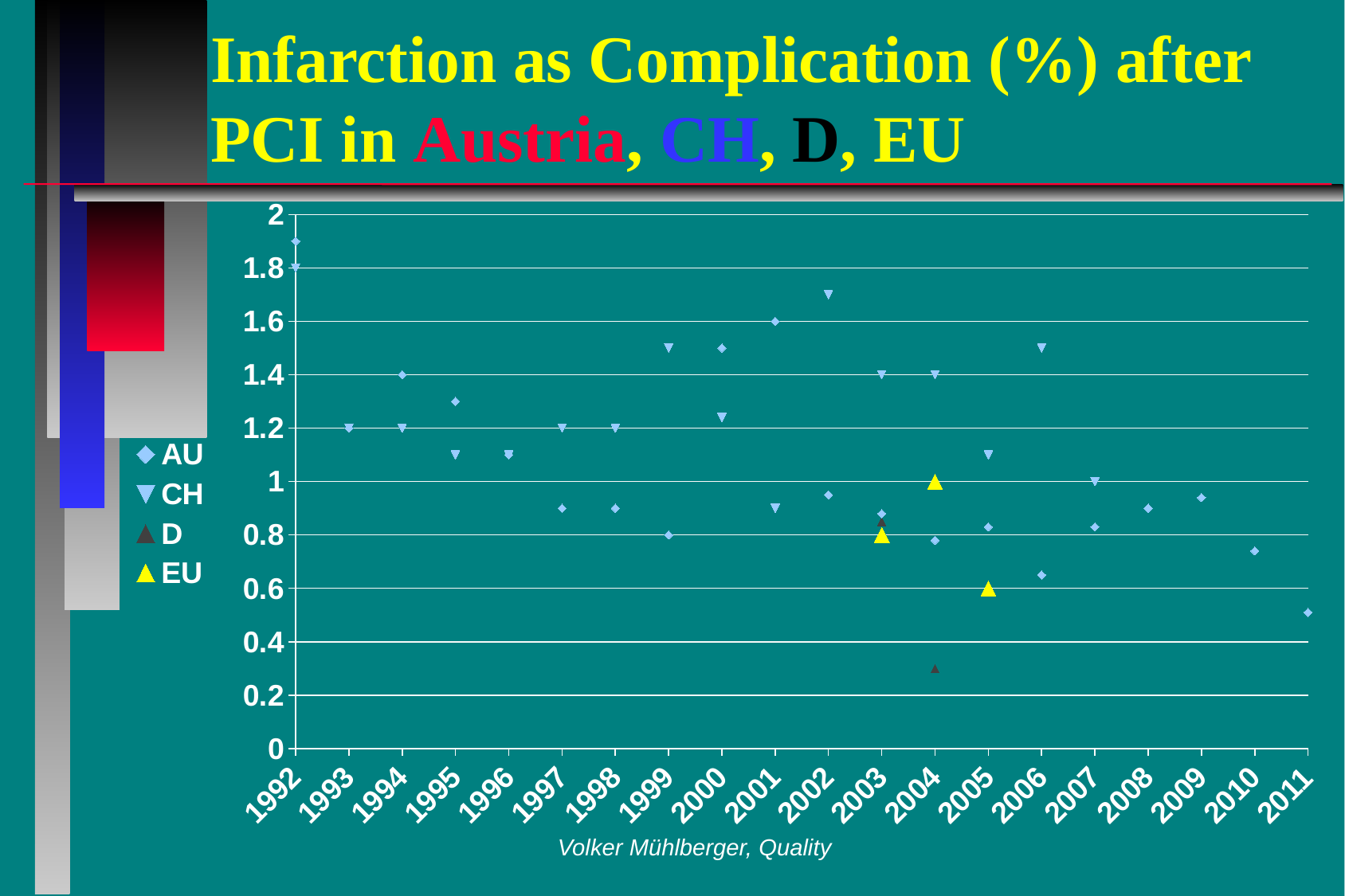
What is the EU value for 2004? 1 What kind of chart is shown on the slide? scatter chart What is the EU value for 2005? 0.6 Is the AU value for 2011 greater or less than 0.6? less In which year does the AU series reach its highest value? 1992 Which is larger, the CH value for 2002 or the AU value for 2002? CH Is the CH value for 2002 greater or less than 1.6? greater Which series has the lowest plotted value on the chart? D How many years are shown on the x axis? 20 How many series does the legend list? 4 Which series is plotted with yellow triangles? EU What is the AU value for 1994? 1.4